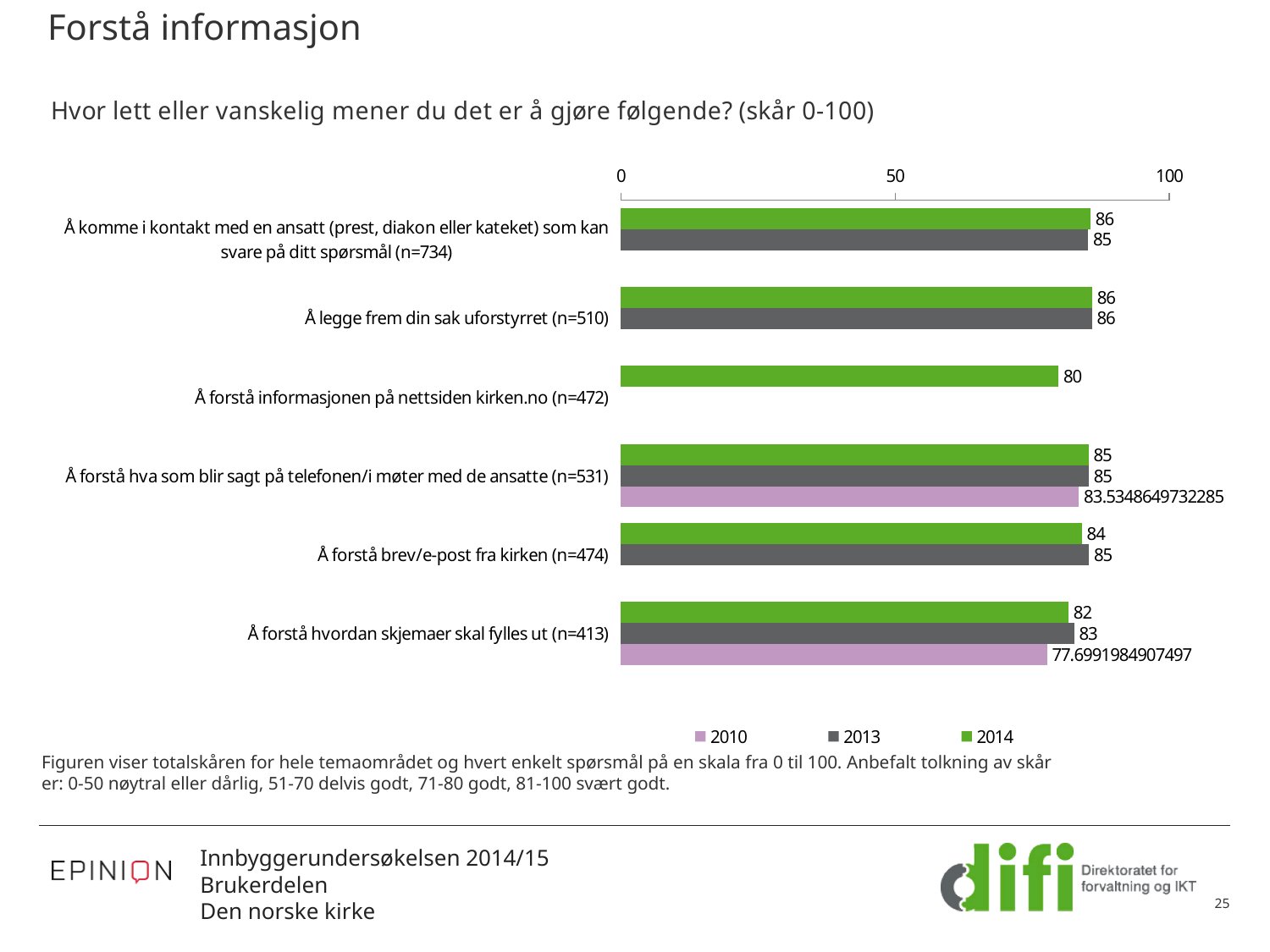
What kind of chart is shown on the slide? Bar chart Which category has the lowest 2013 value? Å forstå hvordan skjemaer skal fylles ut (n=413) How many series does the legend list? 3 Which category has the lowest 2014 value? Å forstå informasjonen på nettsiden kirken.no (n=472) What is the difference between the 2014 and 2013 values for 'Å komme i kontakt med en ansatt (prest, diakon eller kateket) som kan svare på ditt spørsmål (n=734)'? 1 What is the 2010 value for 'Å forstå hvordan skjemaer skal fylles ut (n=413)'? 77.6991984907497 What is the 2014 value for 'Å forstå informasjonen på nettsiden kirken.no (n=472)'? 80 How many categories are shown in the chart? 6 Which is larger for 'Å forstå brev/e-post fra kirken (n=474)': the 2014 value or the 2013 value? 2013 What is the 2014 value for 'Å forstå hvordan skjemaer skal fylles ut (n=413)'? 82 What is the 2013 value for 'Å forstå brev/e-post fra kirken (n=474)'? 85 Is the 2014 value for 'Å legge frem din sak uforstyrret (n=510)' greater or less than 50? greater